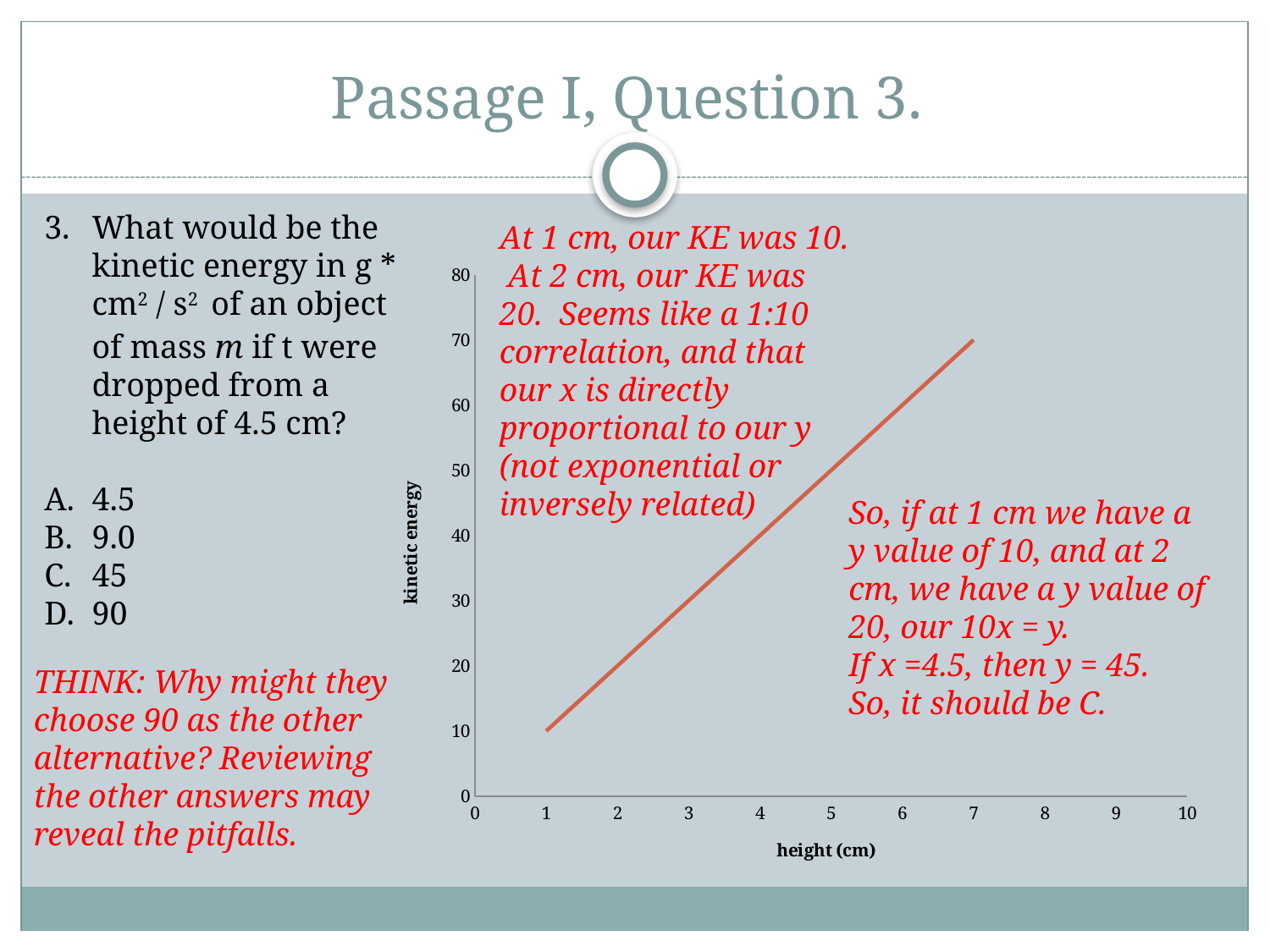
What is the label of the x axis of the chart? height (cm) Which height has the higher kinetic energy on the chart, 2 cm or 6 cm? 6 cm What is the highest value shown on the y axis of the chart? 80 According to the slide, what is the kinetic energy at a height of 1 cm? 10 Does kinetic energy rise or fall as height increases along the x axis? rise According to the slide, what is the kinetic energy at a height of 2 cm? 20 How many lines are plotted on the chart? 1 Is the kinetic energy at a height of 5 cm greater or less than 40? greater What is the kinetic energy value where the line ends, at a height of 7 cm? 70 What kind of chart is shown on the slide? line chart Is the kinetic energy at a height of 3 cm greater or less than 40? less What is the label of the y axis of the chart? kinetic energy